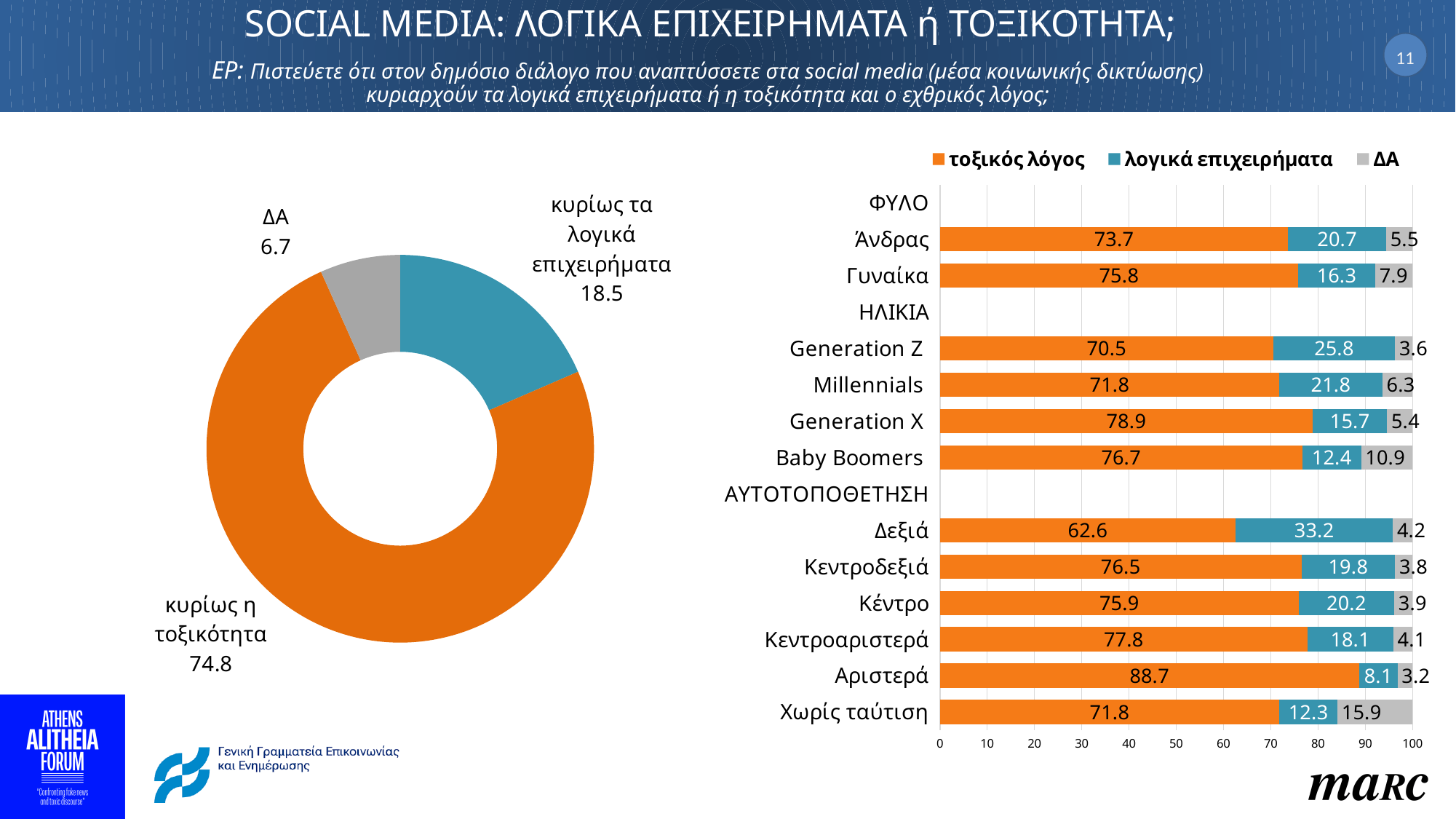
In the stacked bar chart on the right, what is the 'ΔΑ' value for Χωρίς ταύτιση? 15.9 In the stacked bar chart on the right, which category has the highest 'τοξικός λόγος' value? Αριστερά In the stacked bar chart on the right, which category has the lowest 'τοξικός λόγος' value? Δεξιά In the stacked bar chart on the right, what is the 'λογικά επιχειρήματα' value for Generation Z? 25.8 In the donut chart on the left, what is the difference between 'κυρίως η τοξικότητα' and 'κυρίως τα λογικά επιχειρήματα'? 56.3 In the donut chart on the left, which category has the smallest share? ΔΑ In the stacked bar chart on the right, what is the 'τοξικός λόγος' value for Αριστερά? 88.7 In the donut chart on the left, what is the value for 'ΔΑ'? 6.7 How many series does the legend of the stacked bar chart on the right list? 3 What type of chart is shown on the right side of the slide? Stacked bar chart In the stacked bar chart on the right, which is larger: the 'λογικά επιχειρήματα' value for Άνδρας or for Γυναίκα? Άνδρας In the donut chart on the left, what is the value for 'κυρίως η τοξικότητα'? 74.8